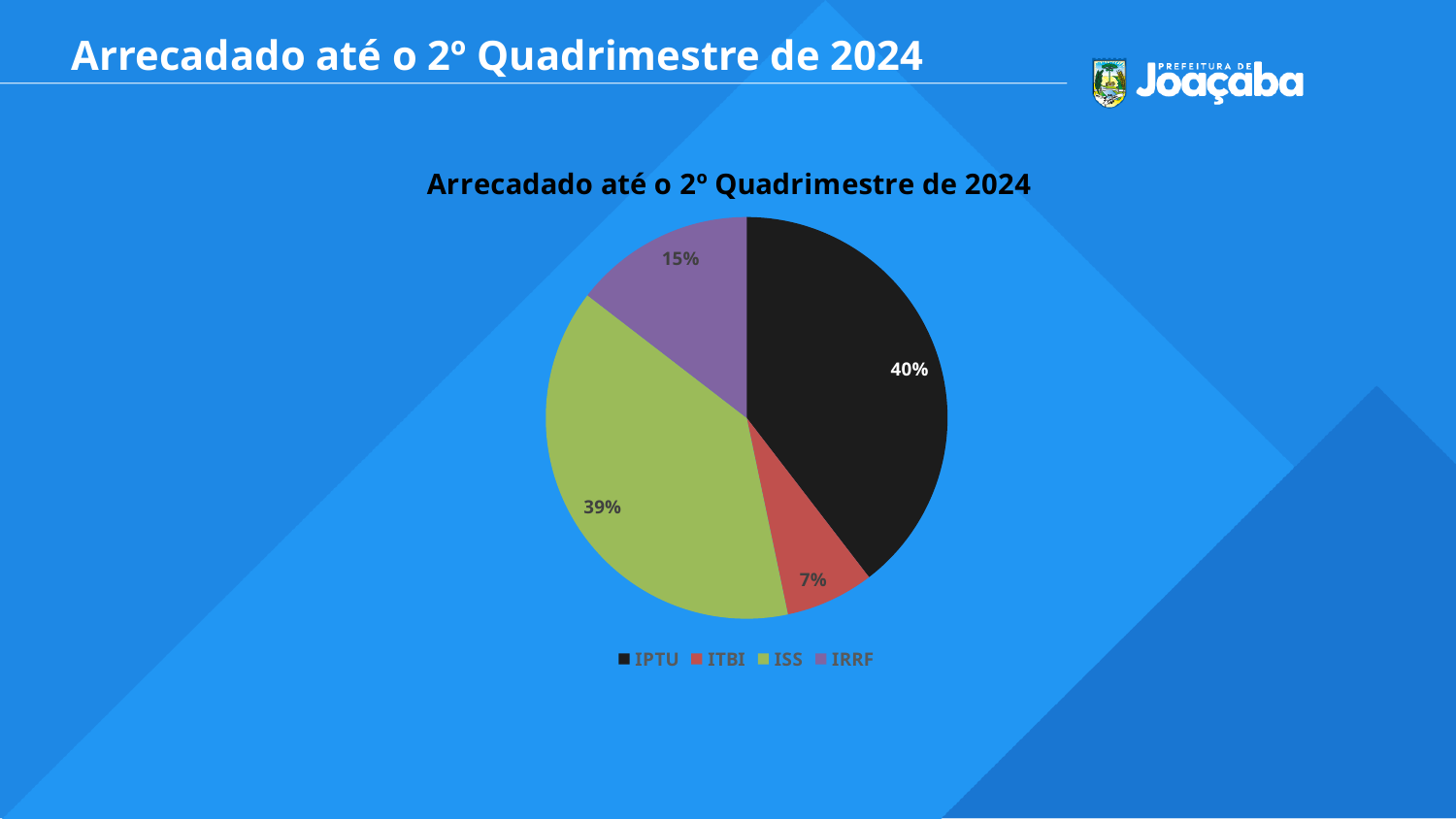
What share of the pie does IPTU represent? 40% Which is larger, the share for ISS or the share for IRRF? ISS What share of the pie does ISS represent? 39% What is the title of the chart? Arrecadado até o 2º Quadrimestre de 2024 How many categories are shown in the pie chart? 4 Which category has the largest slice of the pie? IPTU What type of chart is shown on the slide? Pie chart What share of the pie does ITBI represent? 7% What is the difference in percentage points between the IPTU share and the ITBI share? 33 What is the difference in percentage points between the ISS share and the IRRF share? 24 What share of the pie does IRRF represent? 15% Which category has the smallest slice of the pie? ITBI